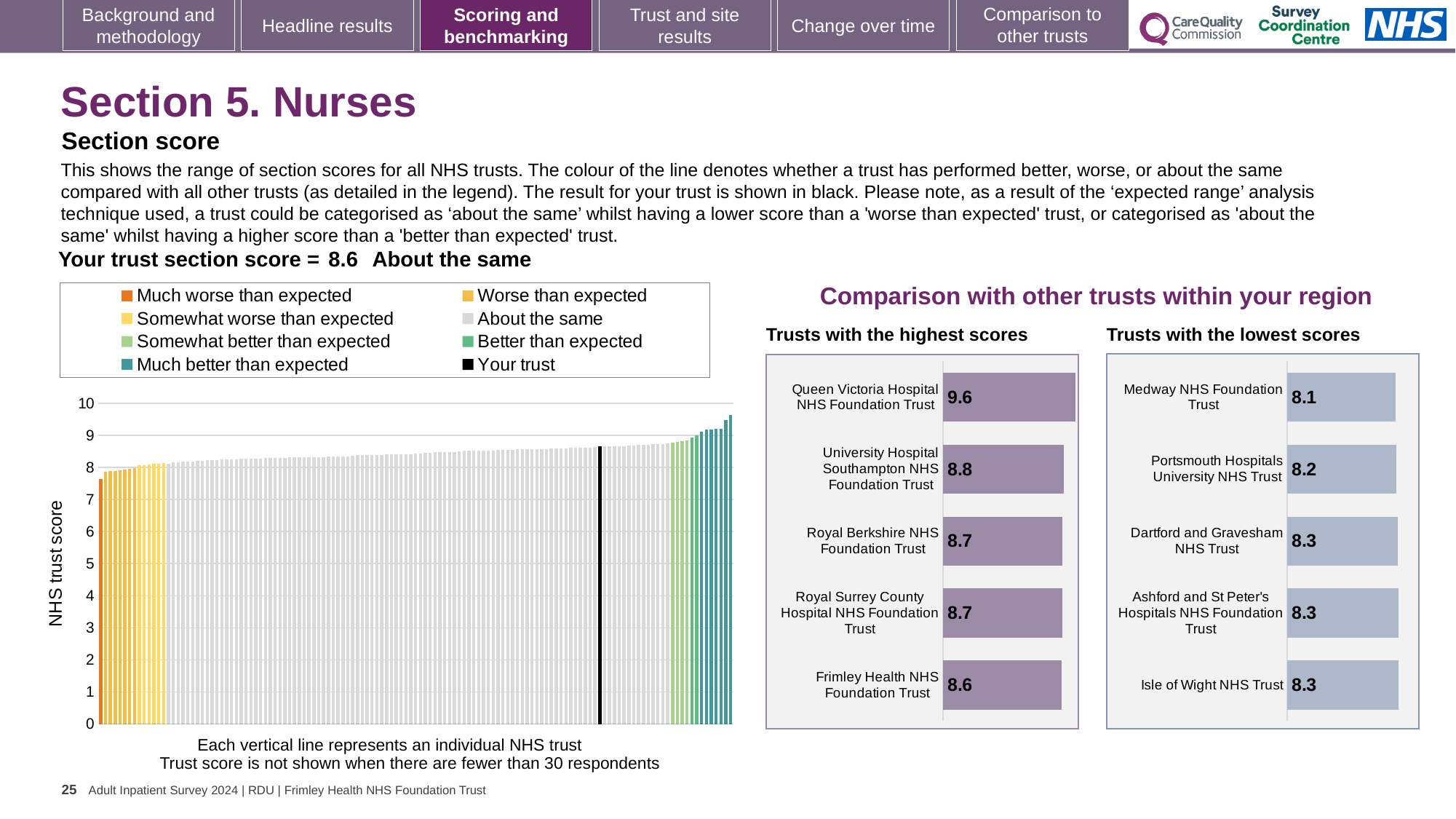
In the 'Trusts with the highest scores' chart, which trust has the highest score? Queen Victoria Hospital NHS Foundation Trust In the 'Trusts with the lowest scores' chart, what is the score for Portsmouth Hospitals University NHS Trust? 8.2 In the 'Trusts with the highest scores' chart, what is the score for Queen Victoria Hospital NHS Foundation Trust? 9.6 Which is larger: the score for Queen Victoria Hospital NHS Foundation Trust in the highest scores chart or the score for Medway NHS Foundation Trust in the lowest scores chart? Queen Victoria Hospital NHS Foundation Trust In the main chart on the left, is the value of the black 'Your trust' bar greater or less than 8? greater How many entries does the legend of the main 'NHS trust score' chart on the left list? 8 In the 'Trusts with the highest scores' chart, what is the difference between the scores of Queen Victoria Hospital NHS Foundation Trust and Frimley Health NHS Foundation Trust? 1.0 In the 'Trusts with the lowest scores' chart, which trust has the lowest score? Medway NHS Foundation Trust In the 'Trusts with the lowest scores' chart, what is the score for Medway NHS Foundation Trust? 8.1 In the 'Trusts with the highest scores' chart, what is the score for Frimley Health NHS Foundation Trust? 8.6 What kind of chart is the main chart on the left showing NHS trust scores? Bar chart How many trusts are shown in the 'Trusts with the lowest scores' chart? 5